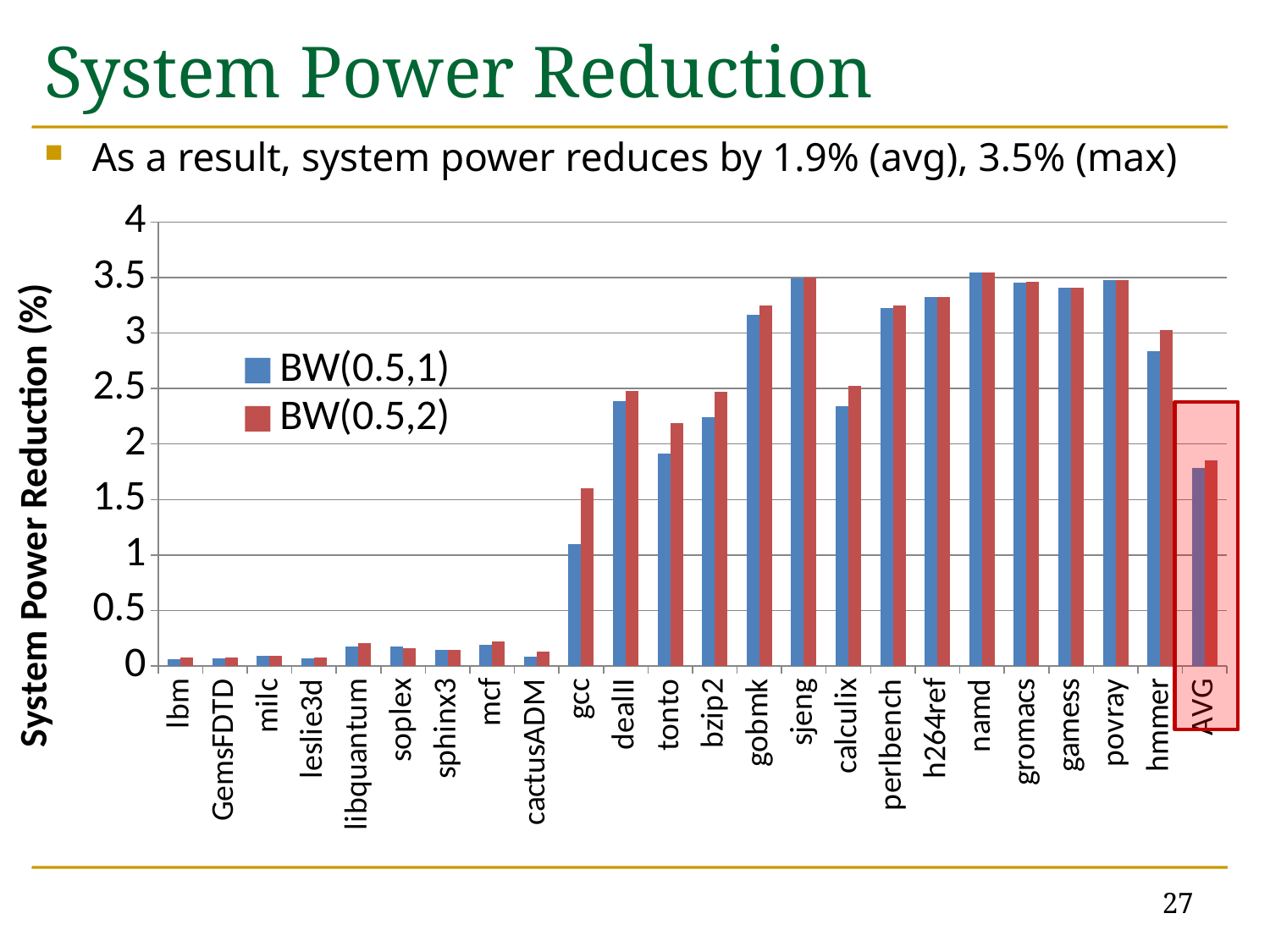
Is the BW(0.5,1) value for tonto greater or less than 2? less For gcc, which series has the larger value, BW(0.5,1) or BW(0.5,2)? BW(0.5,2) Which category on the x axis is highlighted with a red box? AVG What is the label of the y axis? System Power Reduction (%) Is the BW(0.5,2) value for gcc greater or less than 1.5? greater Is the BW(0.5,1) value for hmmer greater or less than 3? less How many categories are plotted along the x axis? 24 For the BW(0.5,1) series, which is larger, sjeng or calculix? sjeng How many series does the legend list? 2 What kind of chart is shown on the slide? bar chart